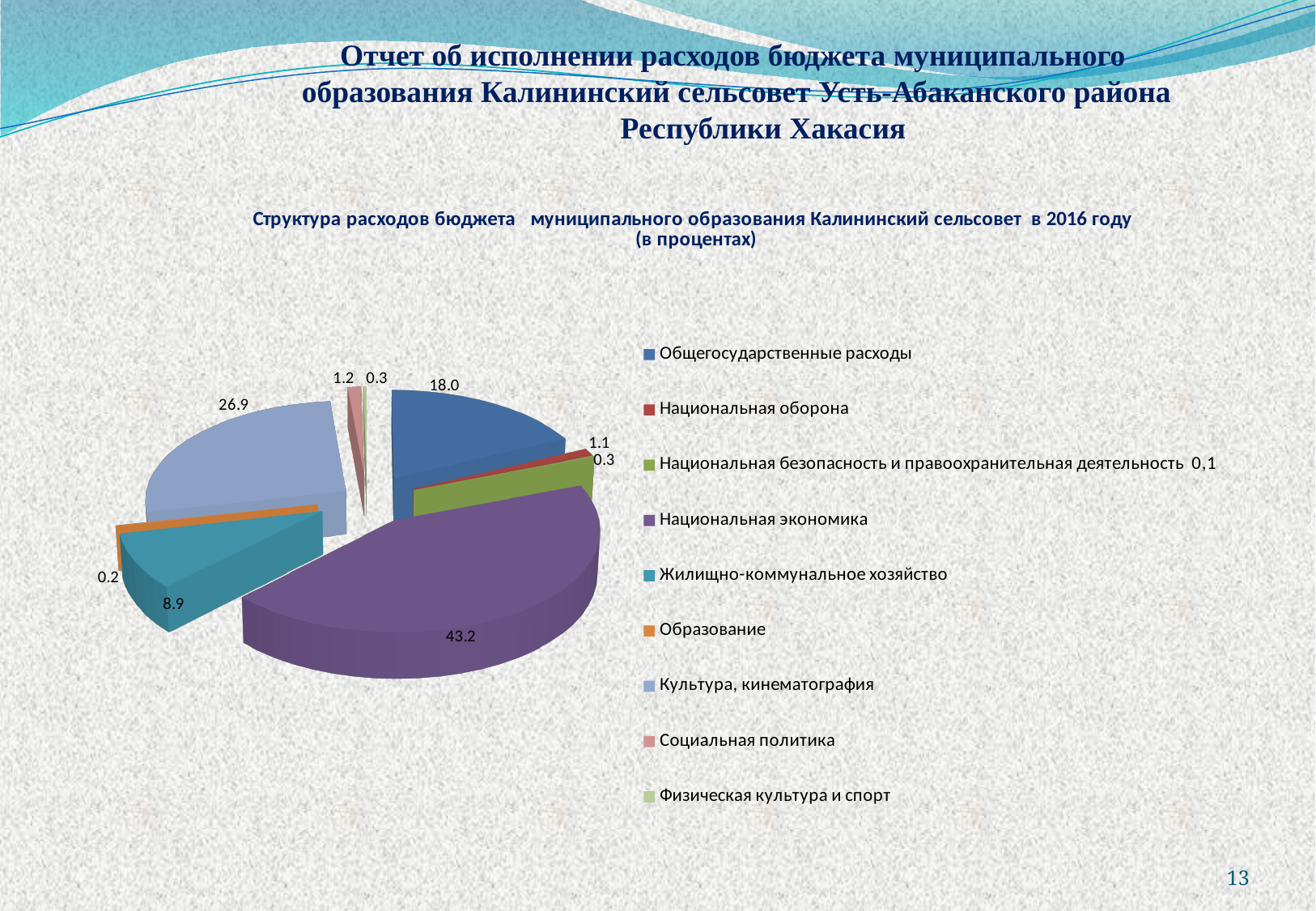
What is the difference between the values for Национальная экономика and Культура, кинематография? 16.3 What type of chart is shown on the slide? Pie chart What is the value shown for Жилищно-коммунальное хозяйство? 8.9 What is the value shown for Образование? 0.2 What is the value shown for Социальная политика? 1.2 Which category has the largest share of the pie? Национальная экономика Which is larger: the value for Общегосударственные расходы or for Жилищно-коммунальное хозяйство? Общегосударственные расходы What is the value shown for Культура, кинематография? 26.9 What is the value shown for Национальная экономика? 43.2 How many categories does the legend of the pie chart list? 9 Which category has the smallest share of the pie? Образование What is the value shown for Общегосударственные расходы? 18.0